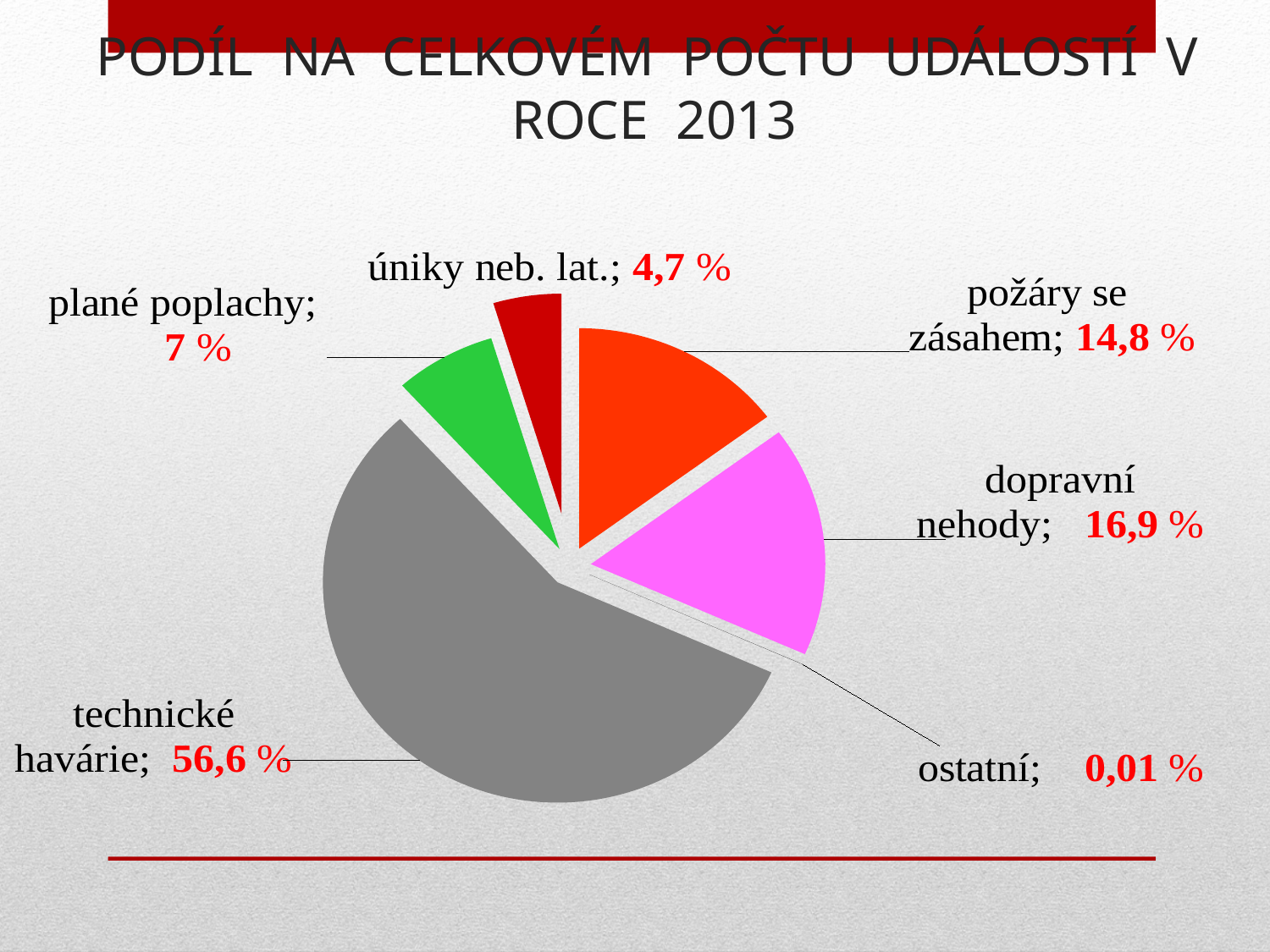
What is the value for technické havárie? 56,6 % What is the value for dopravní nehody? 16,9 % What is the value for požáry se zásahem? 14,8 % What is the value for úniky neb. lat.? 4,7 % How many categories does the pie chart show? 6 What is the difference between dopravní nehody and požáry se zásahem? 2,1 % Which category has the largest share of the pie? technické havárie What is the title of the chart on the slide? PODÍL NA CELKOVÉM POČTU UDÁLOSTÍ V ROCE 2013 Which category has the smallest share of the pie? ostatní What type of chart is shown on the slide? pie chart What is the value for ostatní? 0,01 % Which is larger, plané poplachy or úniky neb. lat.? plané poplachy